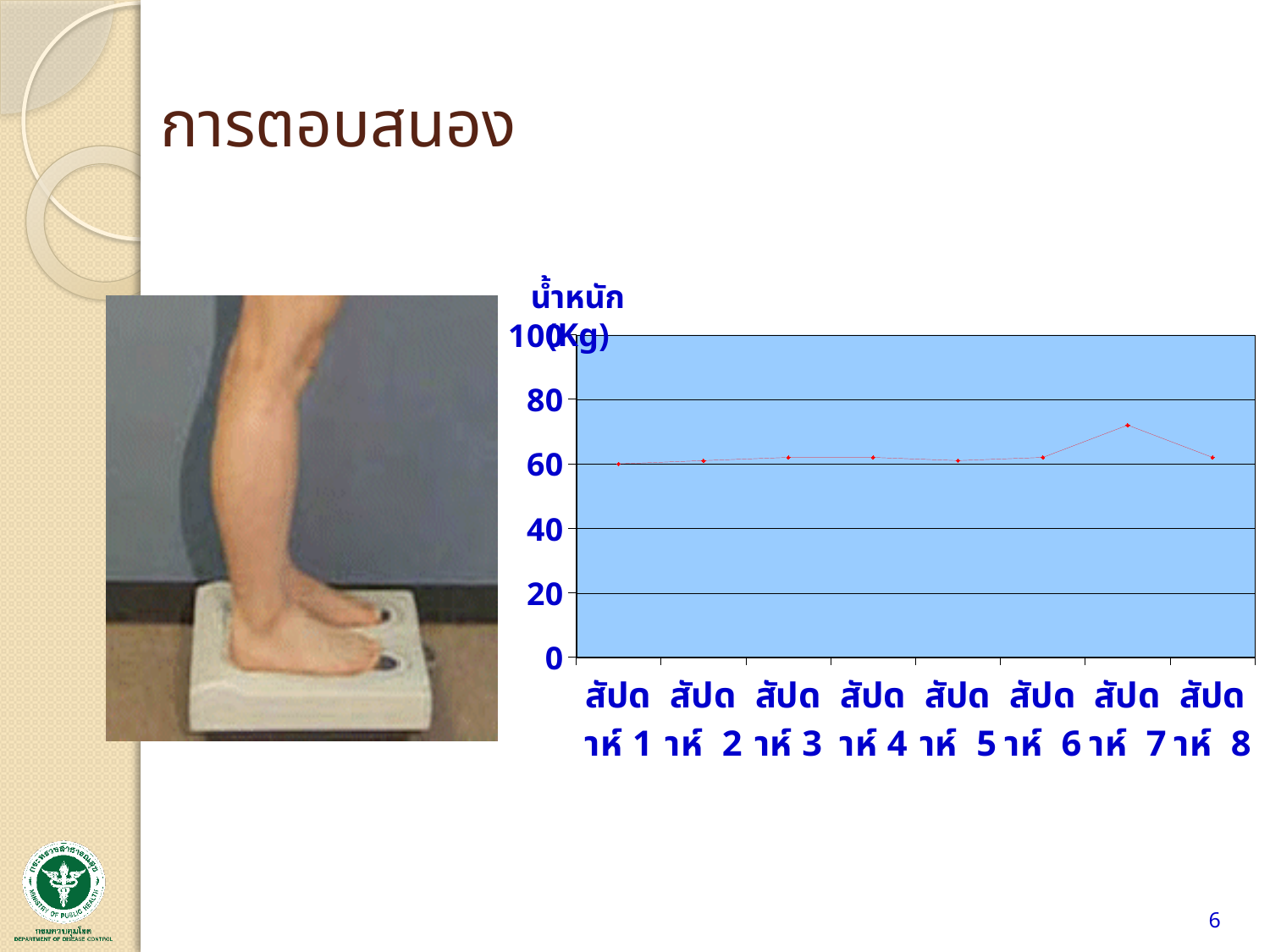
Is the value for สัปดาห์ 1 greater or less than 80? less Which is larger, the value for สัปดาห์ 7 or the value for สัปดาห์ 1? สัปดาห์ 7 What is the title of the slide containing the chart? การตอบสนอง What is the label on the y axis of the chart? น้ำหนัก (Kg) Does the value rise or fall from สัปดาห์ 7 to สัปดาห์ 8? fall What kind of chart is shown on the slide? line chart Which week has the highest value in the chart? สัปดาห์ 7 How many weeks (categories) are plotted on the x axis of the chart? 8 Is the value for สัปดาห์ 7 greater or less than 80? less Does the value rise or fall from สัปดาห์ 6 to สัปดาห์ 7? rise Is the value for สัปดาห์ 7 greater or less than 60? greater